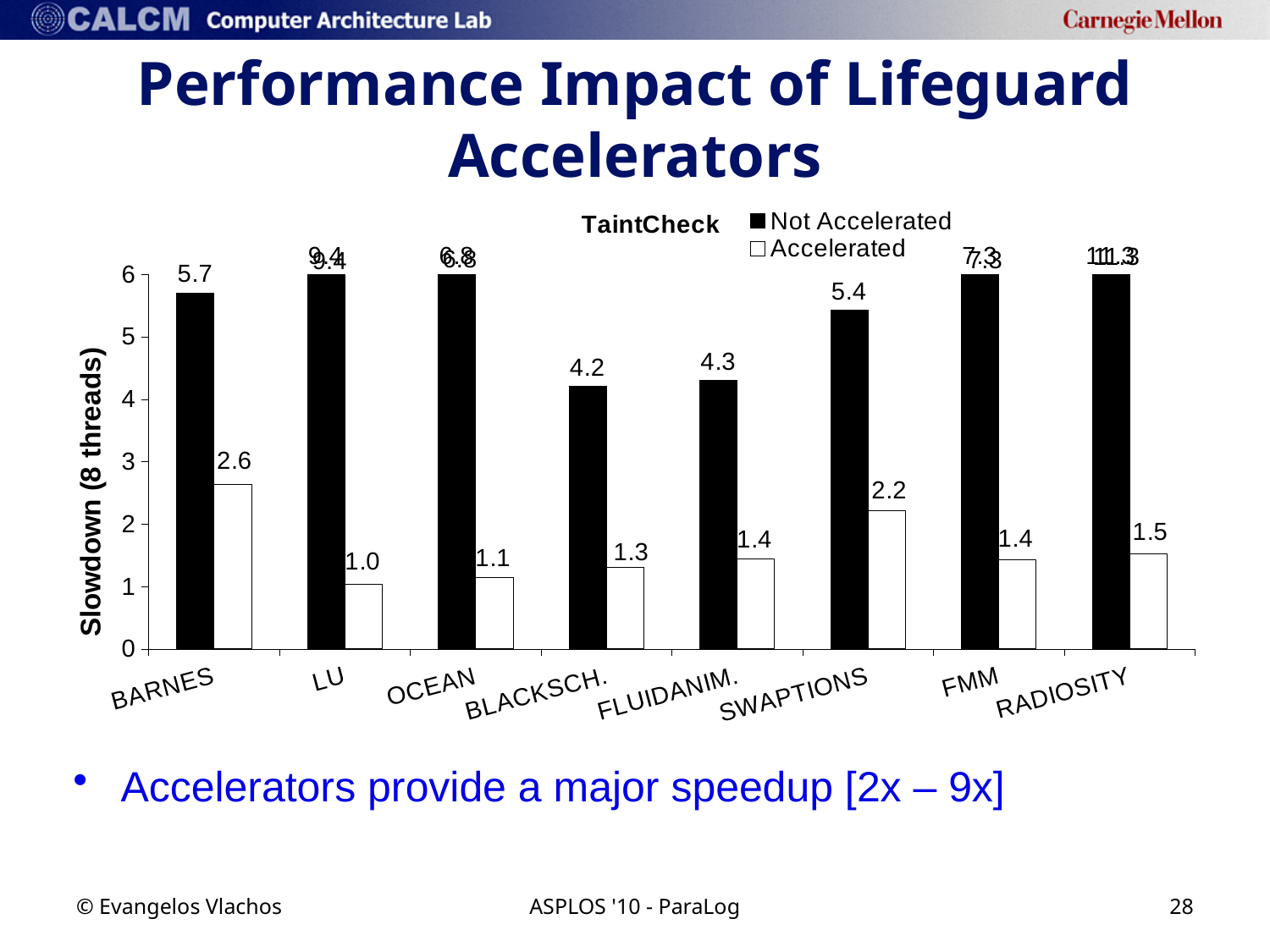
Which is larger, the Accelerated slowdown for BARNES or for SWAPTIONS? BARNES What is the difference between the Not Accelerated and Accelerated slowdown for BARNES? 3.1 What is the Not Accelerated slowdown for BLACKSCH.? 4.2 Is the Not Accelerated slowdown for SWAPTIONS greater or less than 5? greater What is the Accelerated slowdown for SWAPTIONS? 2.2 Which benchmark has the lowest Accelerated slowdown? LU What is the title of the chart? TaintCheck How many series does the legend list? 2 What type of chart is shown on the slide? bar chart How many benchmark categories are shown on the x axis? 8 What is the Not Accelerated slowdown for BARNES? 5.7 Which benchmark has the highest Accelerated slowdown? BARNES